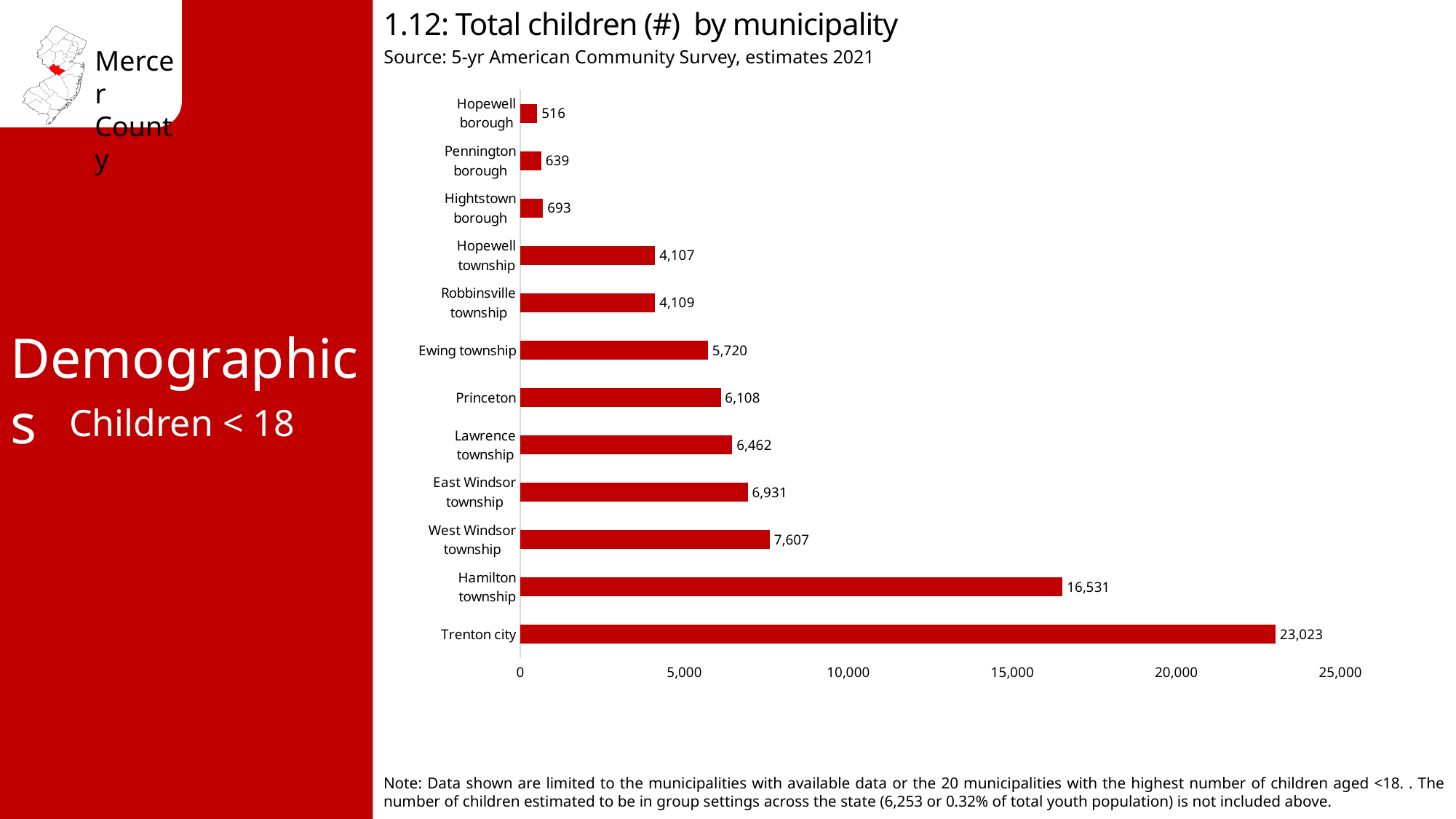
How many municipalities are shown in the chart? 12 What is the difference in the number of children between Pennington borough and Hopewell borough? 123 Which municipality has the lowest number of children? Hopewell borough What is the difference in the number of children between Trenton city and Hamilton township? 6,492 What is the source cited for the chart data? 5-yr American Community Survey, estimates 2021 Which has more children, West Windsor township or East Windsor township? West Windsor township What is the total number of children in Hamilton township? 16,531 What is the total number of children in Princeton? 6,108 What is the total number of children in Trenton city? 23,023 Which municipality has the highest number of children? Trenton city What kind of chart is shown on the slide? bar chart Is the value for Ewing township greater or less than 5,000? greater